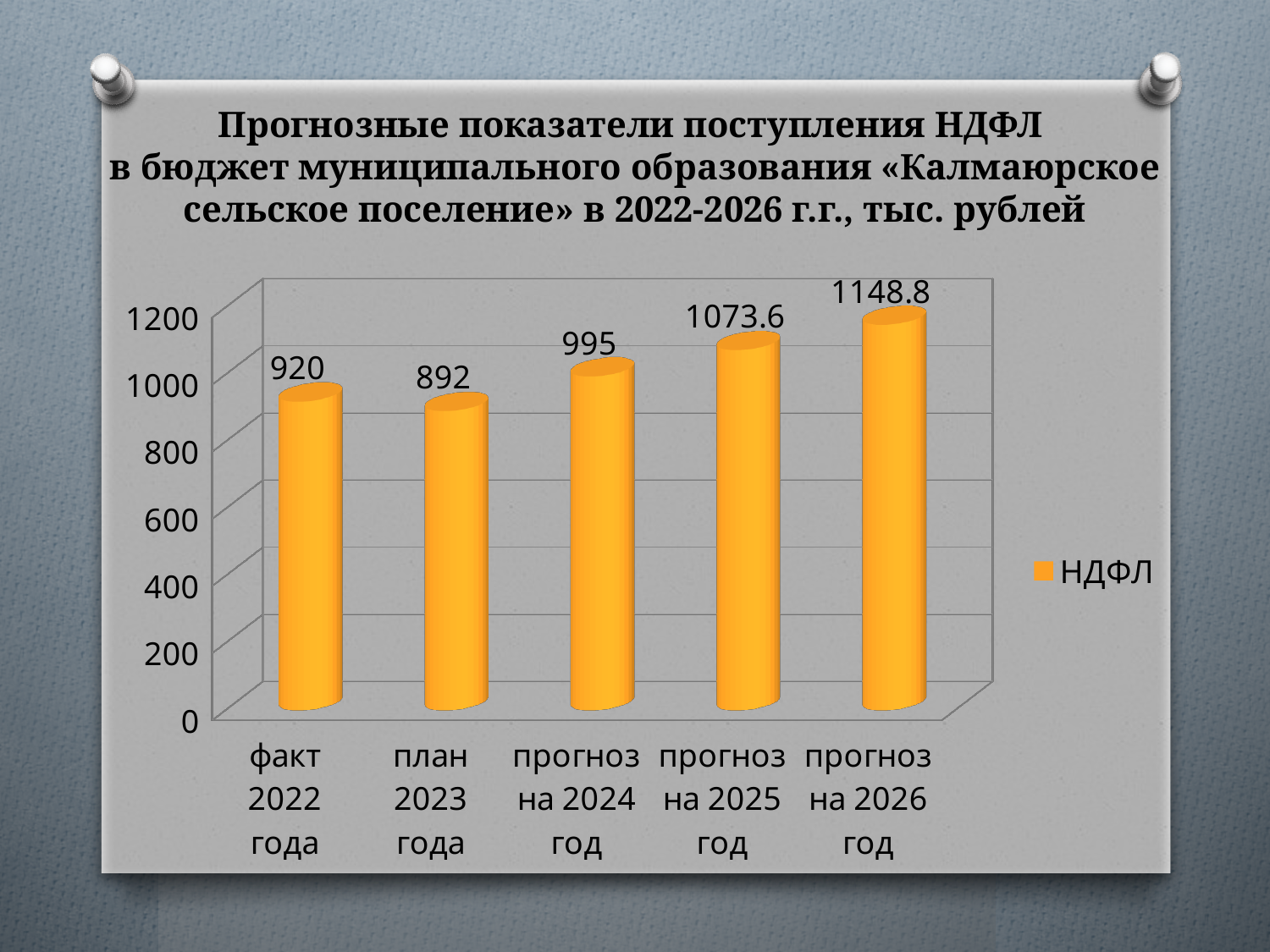
What is the value for план 2023 года? 892 What series name is listed in the legend? НДФЛ What is the value for прогноз на 2026 год? 1148.8 What kind of chart is shown on the slide? bar chart Which is larger, the value for факт 2022 года or план 2023 года? факт 2022 года Which category has the highest value? прогноз на 2026 год Which category has the lowest value? план 2023 года Is the value for прогноз на 2025 год greater or less than 1000? greater What is the difference between the values for прогноз на 2025 год and прогноз на 2024 год? 78.6 What is the value for прогноз на 2024 год? 995 What is the value for факт 2022 года? 920 How many categories are shown on the x axis? 5